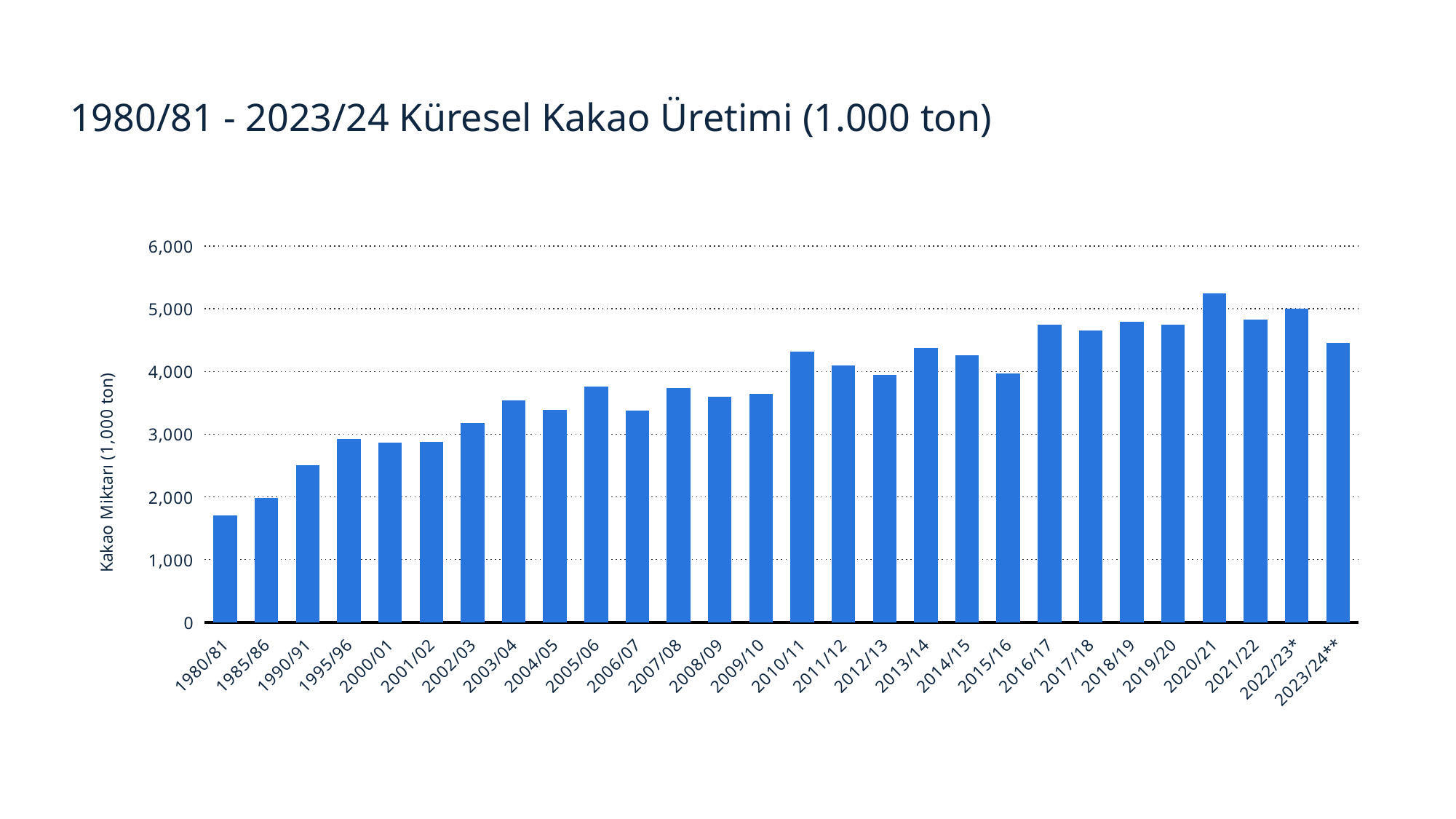
Is the value for 1980/81 greater or less than 2,000? less Is the value for 2020/21 greater or less than 5,000? greater Which is larger, the value for 2009/10 or the value for 2010/11? 2010/11 What kind of chart is shown on the slide? bar chart Is the value for 2005/06 greater or less than 3,000? greater Which season has the lowest cocoa production? 1980/81 Overall, do the values rise or fall from 1980/81 to 2023/24**? rise What is the title of the chart? 1980/81 - 2023/24 Küresel Kakao Üretimi (1.000 ton) What is the label on the vertical axis of the chart? Kakao Miktarı (1,000 ton) Which season has the highest cocoa production? 2020/21 How many seasons (bars) are shown on the x axis? 28